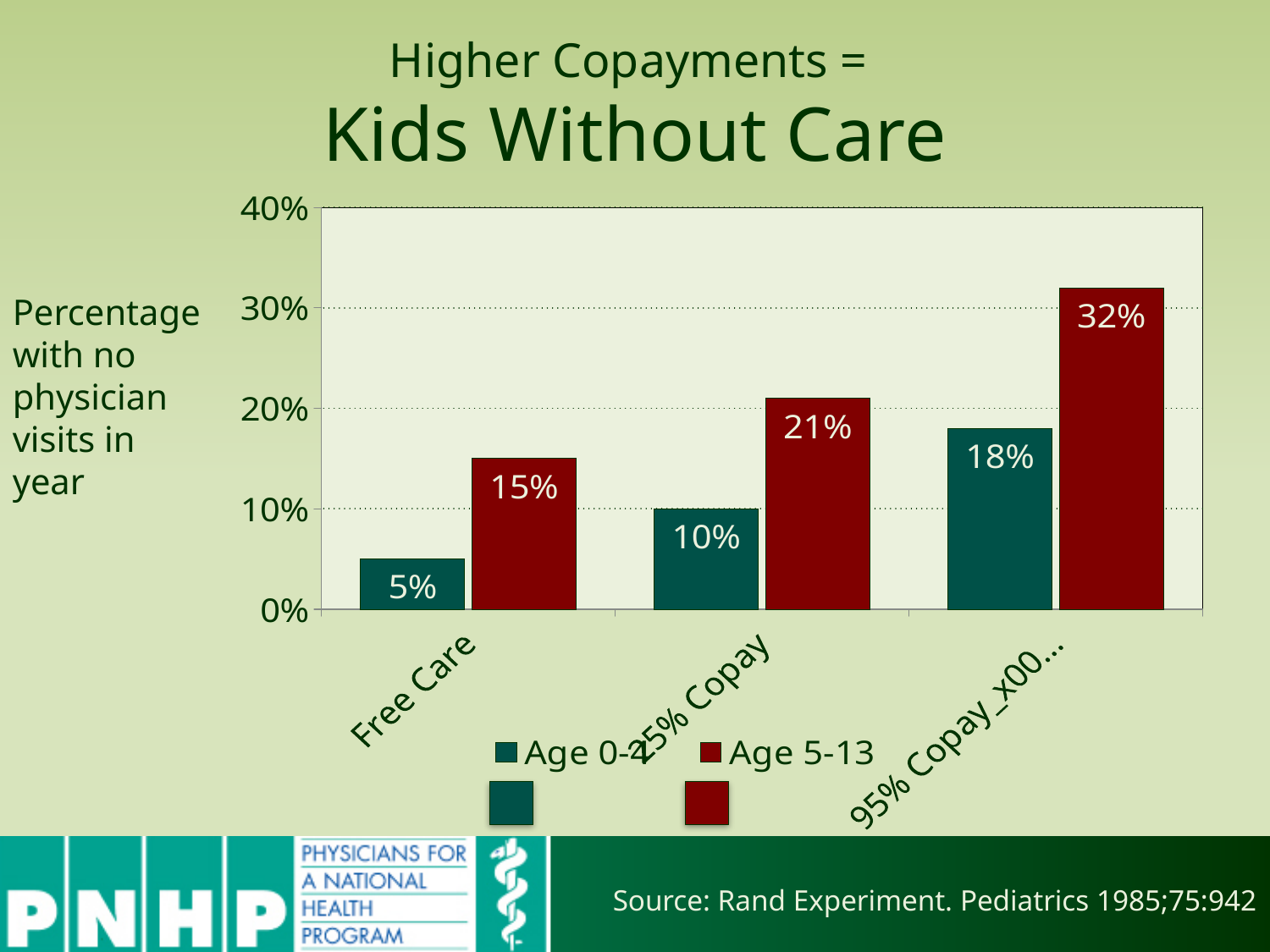
Which category has the lowest value for the teal (younger age group) series? Free Care Do the Age 5-13 values rise or fall as copayment increases from Free Care to 95% Copay? Rise What is the value of the teal (younger age group) bar under 95% Copay? 18% What is the value for Age 5-13 under 95% Copay? 32% What kind of chart is shown on the slide? Bar chart How many copayment categories are shown on the x axis? 3 Which category has the highest value for Age 5-13? 95% Copay How many series does the legend list? 2 What is the difference between the Age 5-13 value and the teal bar value under 25% Copay? 11% What is the value of the teal (younger age group) bar under 25% Copay? 10% What is the value for Age 5-13 under Free Care? 15% Which is larger: the Age 5-13 value under Free Care or the teal bar value under 95% Copay? Teal bar under 95% Copay (18%)